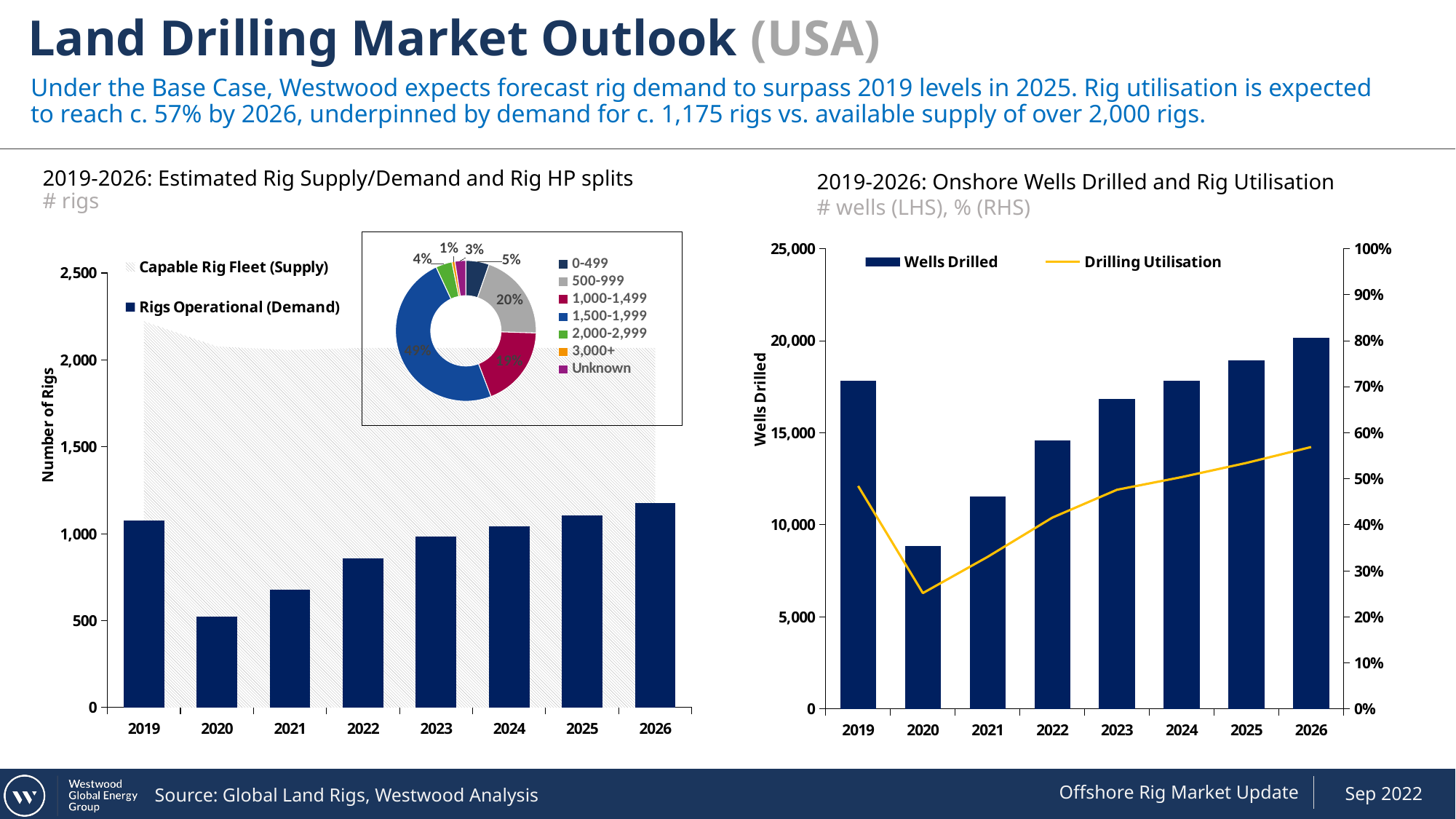
In the '2019-2026: Estimated Rig Supply/Demand and Rig HP splits' chart, which year has the lowest Rigs Operational (Demand) bar? 2020 How many years are shown on the x axis of the '2019-2026: Estimated Rig Supply/Demand and Rig HP splits' chart? 8 In the '2019-2026: Estimated Rig Supply/Demand and Rig HP splits' chart, which year has the highest Rigs Operational (Demand) bar? 2026 In the '2019-2026: Estimated Rig Supply/Demand and Rig HP splits' chart, is the Rigs Operational (Demand) value for 2026 greater or less than 1,000? greater In the '2019-2026: Onshore Wells Drilled and Rig Utilisation' chart, is the Drilling Utilisation value for 2026 greater or less than 50%? greater In the Rig HP splits donut chart, what share does the 500-999 category have? 20% In the '2019-2026: Onshore Wells Drilled and Rig Utilisation' chart, is the Wells Drilled value for 2020 greater or less than 10,000? less In the '2019-2026: Estimated Rig Supply/Demand and Rig HP splits' chart, do the Rigs Operational (Demand) bars rise or fall from 2020 to 2026? rise How many categories does the legend of the Rig HP splits donut chart list? 7 In the Rig HP splits donut chart, which HP category has the largest share? 1,500-1,999 In the '2019-2026: Onshore Wells Drilled and Rig Utilisation' chart, which year has the lowest Wells Drilled bar? 2020